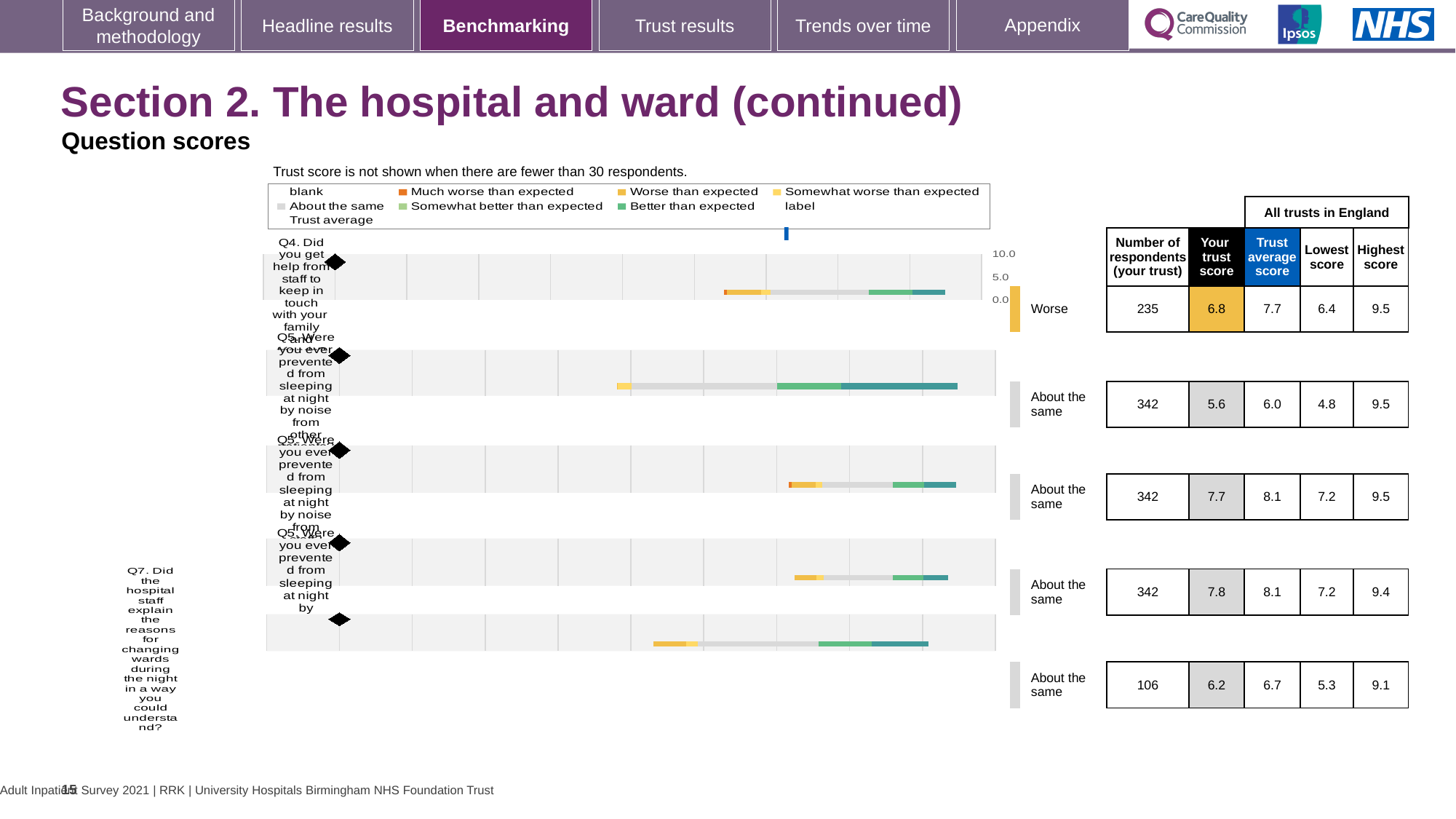
What kind of chart is used to show the question scores on this slide? bar chart What is the difference between the trust average score and your trust score for Q4? 0.9 How many question bars are plotted in the chart? 5 What is 'Your trust score' for Q4 (help from staff to keep in touch with family and friends)? 6.8 What is the highest 'Your trust score' value shown in the table? 7.8 What is the number of respondents for Q7 (explaining reasons for changing wards during the night)? 106 For Q7, which is larger: your trust score or the trust average score? Trust average score What is the maximum value shown on the chart's score axis? 10.0 What is the 'Trust average score' for Q4? 7.7 What is the lowest 'Your trust score' value shown in the table? 5.6 What is the 'Highest score' for Q7? 9.1 Which question is rated 'Worse' rather than 'About the same'? Q4